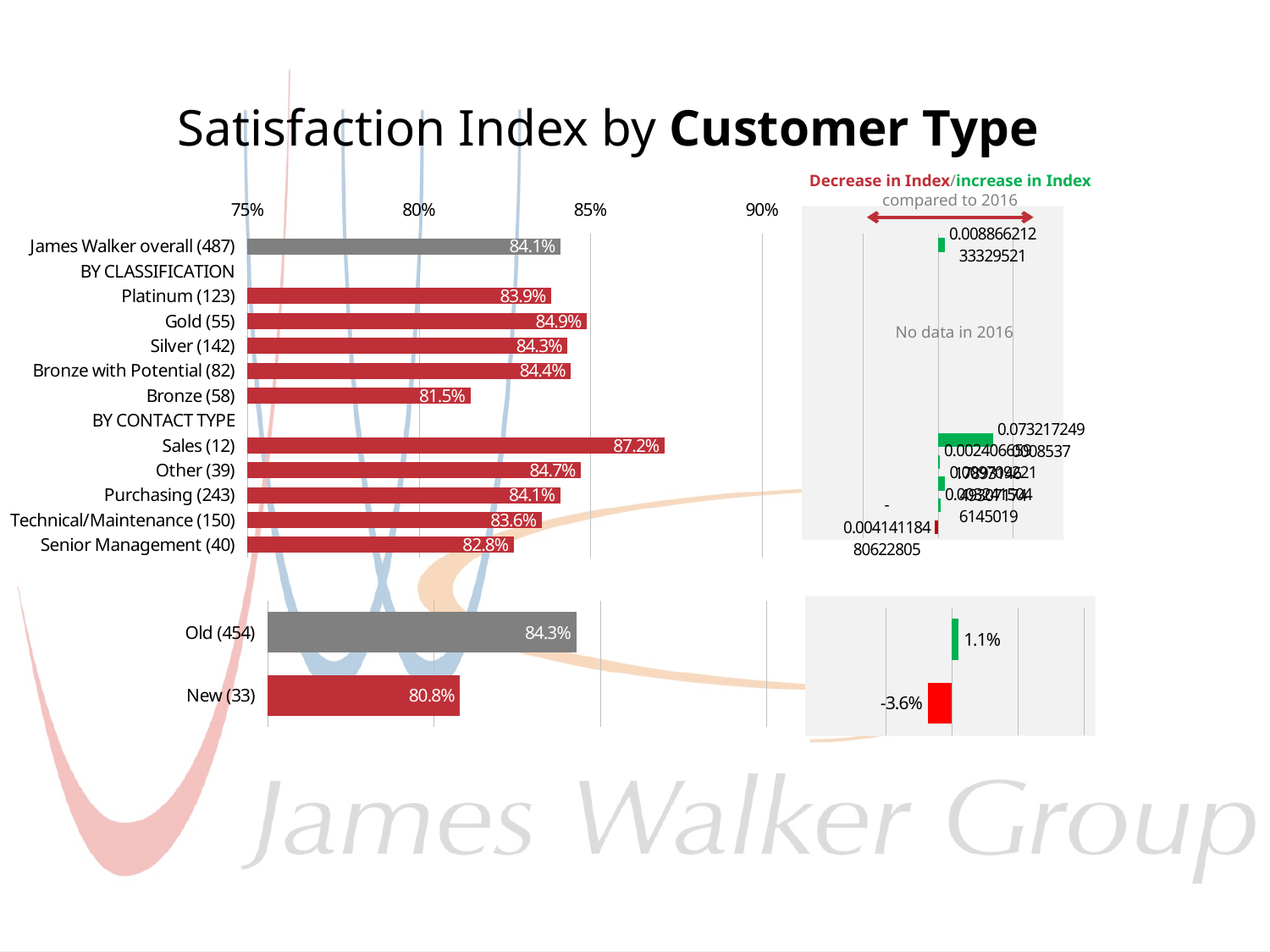
In the main Satisfaction Index by Customer Type chart, what is the value for Bronze (58)? 81.5% What kind of chart is the main Satisfaction Index by Customer Type chart? bar chart In the lower-left chart comparing Old and New customers, what is the value for New (33)? 80.8% In the main Satisfaction Index by Customer Type chart, what is the value for Technical/Maintenance (150)? 83.6% In the main Satisfaction Index by Customer Type chart, which category has the highest satisfaction index? Sales (12) In the main Satisfaction Index by Customer Type chart, what is the value for James Walker overall (487)? 84.1% In the lower-right chart showing change compared to 2016, what is the value for New (33)? -3.6% In the main Satisfaction Index by Customer Type chart, what is the difference between the values for Gold (55) and Bronze (58)? 3.4 percentage points In the main Satisfaction Index by Customer Type chart, which category has the lowest satisfaction index? Bronze (58) How many bars are plotted in the main Satisfaction Index by Customer Type chart? 11 In the main Satisfaction Index by Customer Type chart, is the value for Sales (12) greater or less than 85%? greater In the main Satisfaction Index by Customer Type chart, which is larger, the value for Other (39) or the value for Purchasing (243)? Other (39)